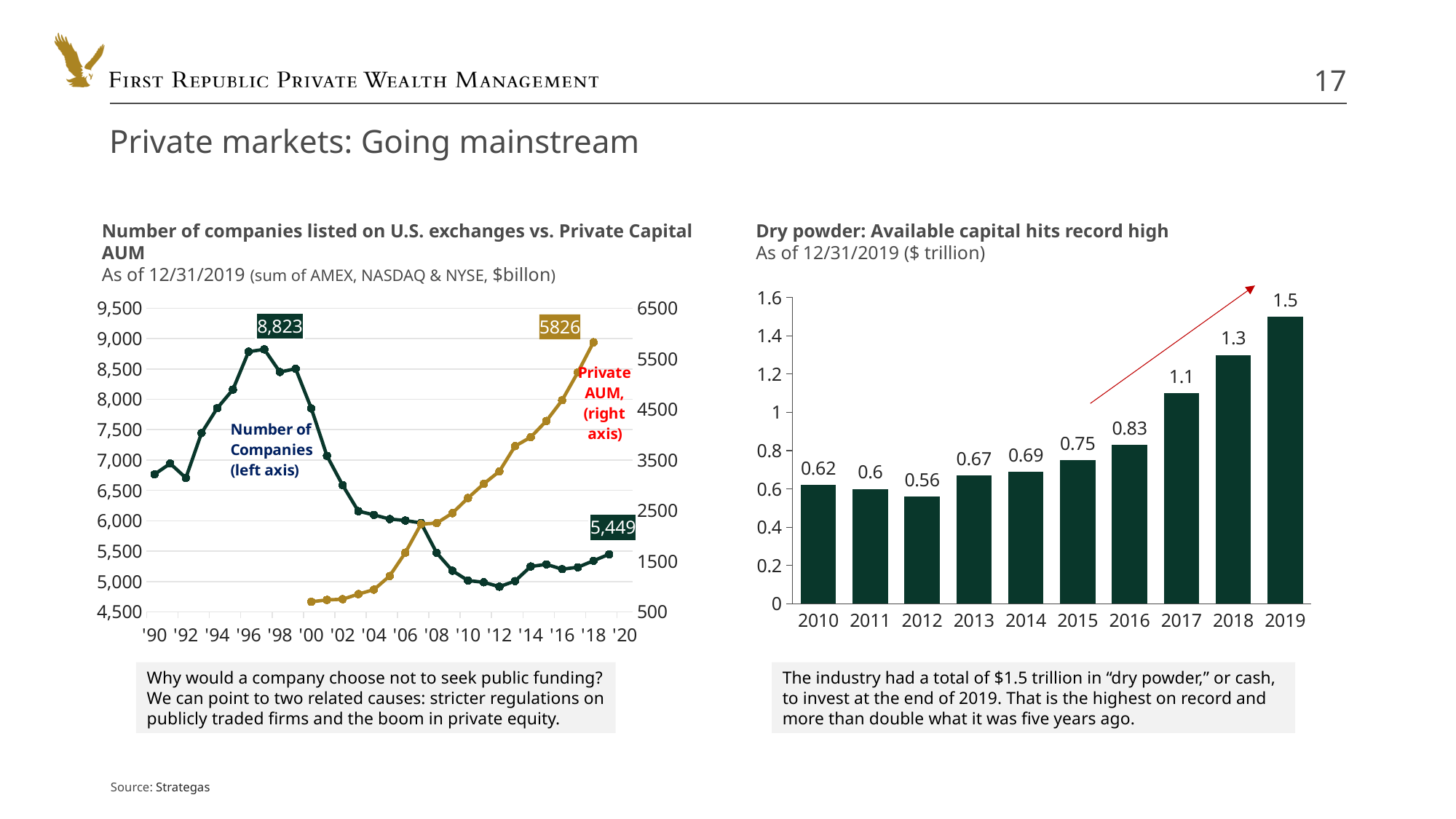
On the 'Dry powder: Available capital hits record high' chart, which year has the lowest value? 2012 On the 'Dry powder: Available capital hits record high' chart, do the values generally rise or fall from 2013 to 2019? Rise On the 'Dry powder: Available capital hits record high' chart, what is the value for 2012? 0.56 On the 'Dry powder: Available capital hits record high' chart, what is the value for 2019? 1.5 On the 'Number of companies listed on U.S. exchanges vs. Private Capital AUM' chart, what is the peak value labeled for the number of companies? 8,823 What kind of chart is the 'Dry powder: Available capital hits record high' chart? Bar chart On the 'Number of companies listed on U.S. exchanges vs. Private Capital AUM' chart, what is the latest labeled value for the number of companies? 5,449 On the 'Dry powder: Available capital hits record high' chart, how many years are shown? 10 On the 'Dry powder: Available capital hits record high' chart, which year has the highest value? 2019 What kind of chart is the 'Number of companies listed on U.S. exchanges vs. Private Capital AUM' chart? Line chart On the 'Number of companies listed on U.S. exchanges vs. Private Capital AUM' chart, what is the latest labeled value for Private AUM? 5826 On the 'Dry powder: Available capital hits record high' chart, what is the difference between the 2019 and 2015 values? 0.75